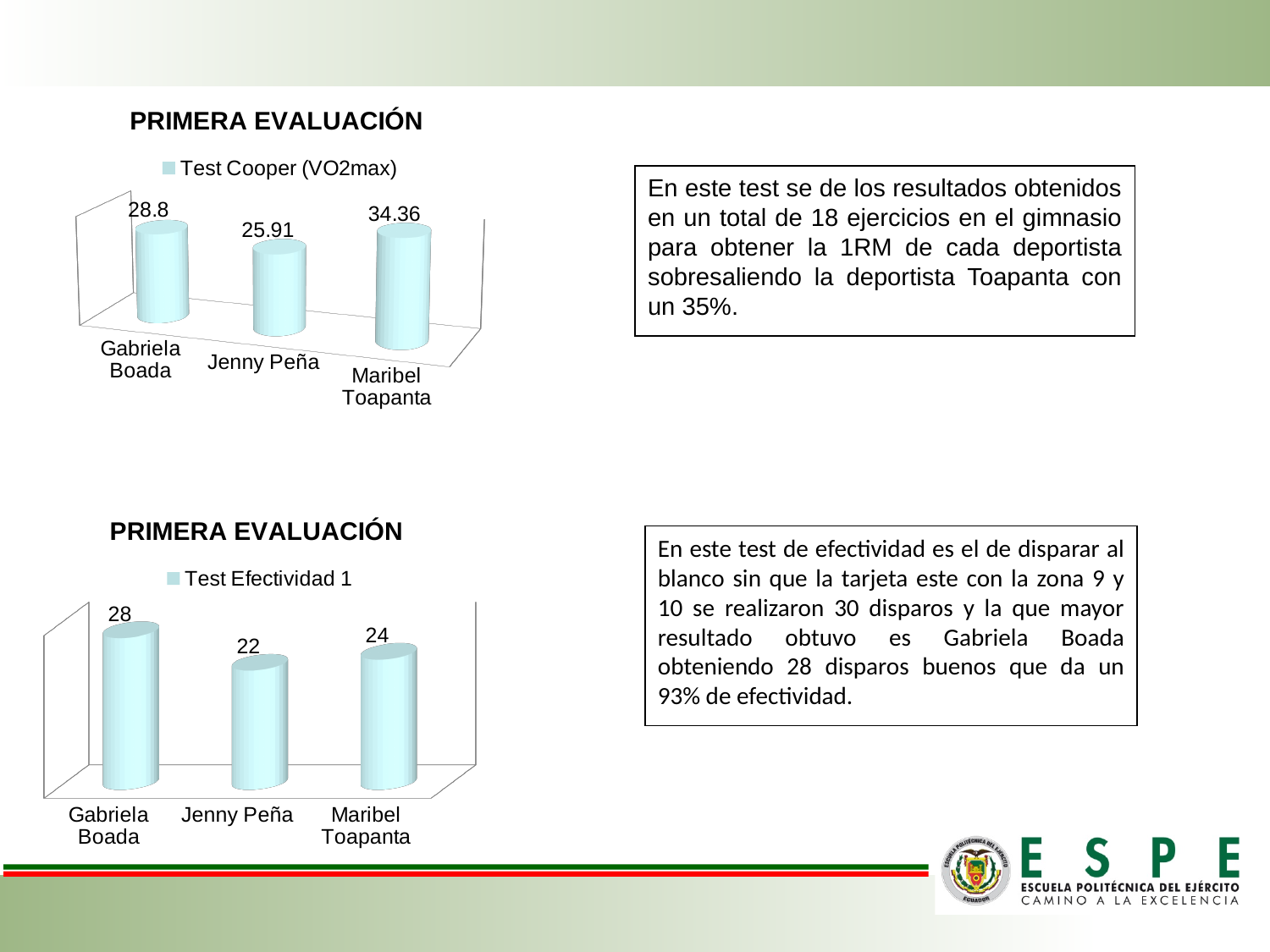
In the bottom chart (Test Efectividad 1), what is the value for Jenny Peña? 22 In the top chart (Test Cooper (VO2max)), what is the value for Gabriela Boada? 28.8 In the bottom chart (Test Efectividad 1), what is the difference between Gabriela Boada's and Jenny Peña's values? 6 How many categories are shown in the top chart (Test Cooper (VO2max))? 3 In the bottom chart (Test Efectividad 1), which is larger, the value for Maribel Toapanta or the value for Jenny Peña? Maribel Toapanta In the top chart (Test Cooper (VO2max)), which athlete has the lowest value? Jenny Peña In the top chart (Test Cooper (VO2max)), which athlete has the highest value? Maribel Toapanta In the bottom chart (Test Efectividad 1), what is the value for Maribel Toapanta? 24 What kind of chart is the bottom chart (Test Efectividad 1)? Bar chart In the bottom chart (Test Efectividad 1), which athlete has the highest value? Gabriela Boada In the top chart (Test Cooper (VO2max)), what is the difference between Maribel Toapanta's and Gabriela Boada's values? 5.56 In the top chart (Test Cooper (VO2max)), what is the value for Jenny Peña? 25.91